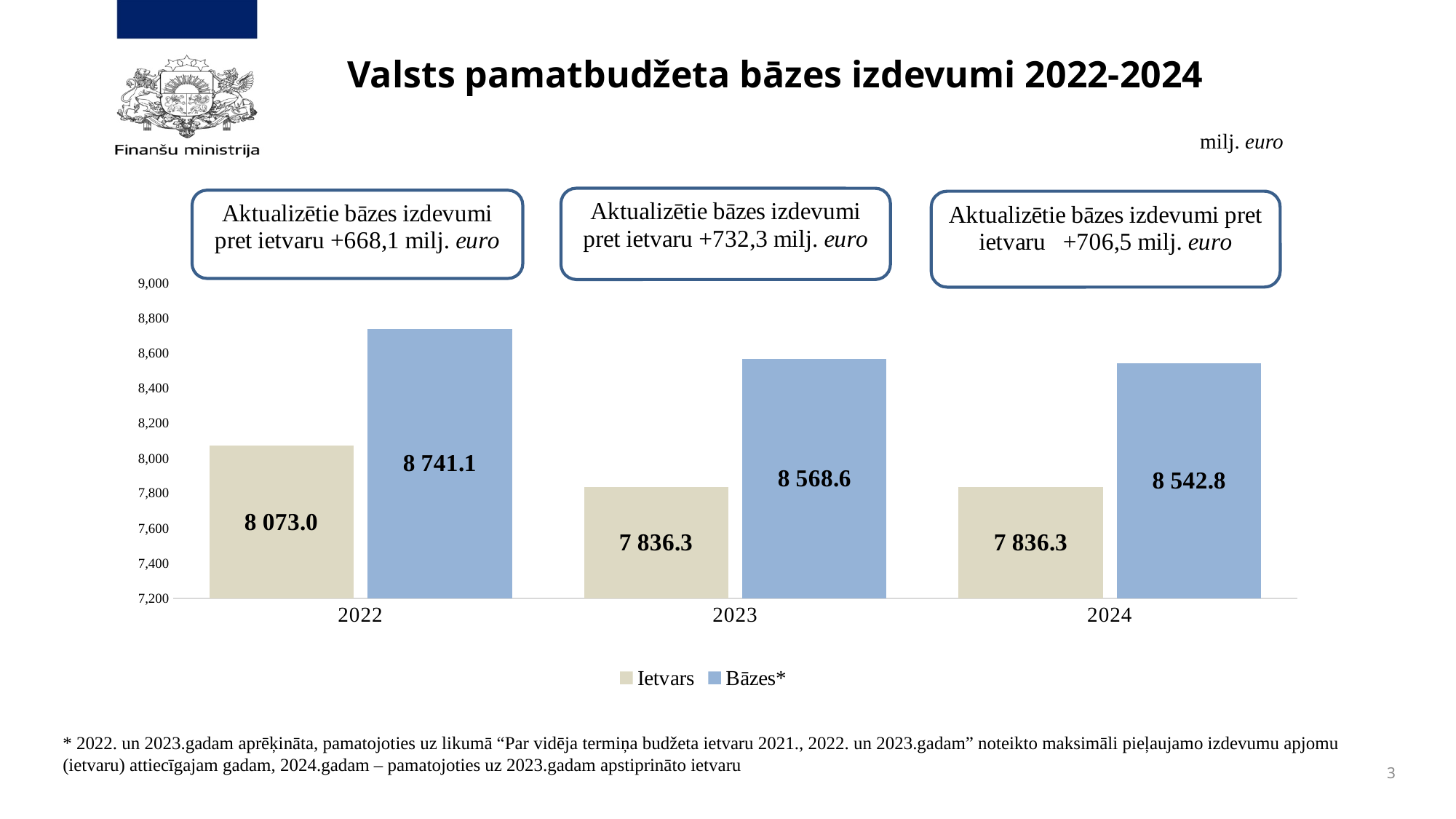
Is the Ietvars value for 2022 greater or less than 8,000? greater What is the Ietvars value for 2023? 7 836.3 What is the Ietvars value for 2022? 8 073.0 Which is larger for 2024, the Ietvars value or the Bāzes* value? Bāzes* Which year has the lowest Bāzes* value? 2024 What kind of chart is shown on the slide? bar chart What is the Bāzes* value for 2022? 8 741.1 What is the difference between the Bāzes* and Ietvars values for 2023? 732.3 How many series does the legend list? 2 What is the Bāzes* value for 2024? 8 542.8 How many years are shown on the x axis? 3 Which year has the highest Bāzes* value? 2022